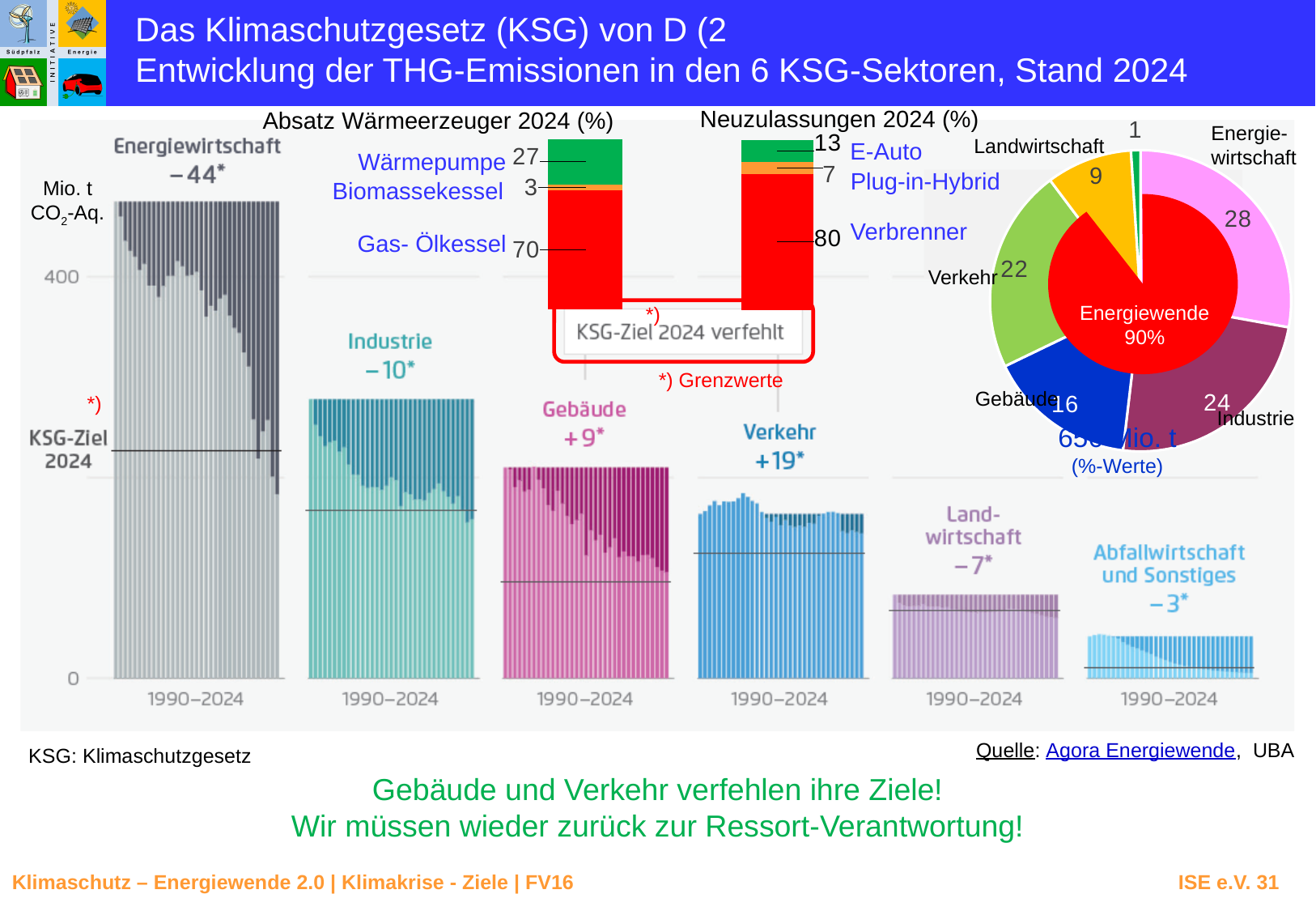
In the stacked bar 'Neuzulassungen 2024 (%)', what is the difference between Verbrenner and E-Auto? 67 In the main chart of THG emissions by KSG sector, what change is shown for Energiewirtschaft? −44* In the main chart of THG emissions by KSG sector, what change is shown for Verkehr? +19* In the stacked bar 'Absatz Wärmeerzeuger 2024 (%)', what is the value for Wärmepumpe? 27 In the pie chart on the right, which sector has the highest value? Energiewirtschaft In the main chart of THG emissions by KSG sector, how many sectors are shown? 6 In the stacked bar 'Neuzulassungen 2024 (%)', what is the value for Verbrenner? 80 In the main chart of THG emissions by KSG sector, is the Energiewirtschaft value at the start of the 1990–2024 period greater or less than 400 Mio. t CO2-Aq.? greater In the main chart of THG emissions by KSG sector, do the Energiewirtschaft emissions rise or fall from 1990 to 2024? fall In the stacked bar 'Absatz Wärmeerzeuger 2024 (%)', what is the difference between Gas- Ölkessel and Wärmepumpe? 43 In the main chart of THG emissions by KSG sector, which sector shows the larger increase, Gebäude or Verkehr? Verkehr In the pie chart on the right, what is the value for Industrie? 24